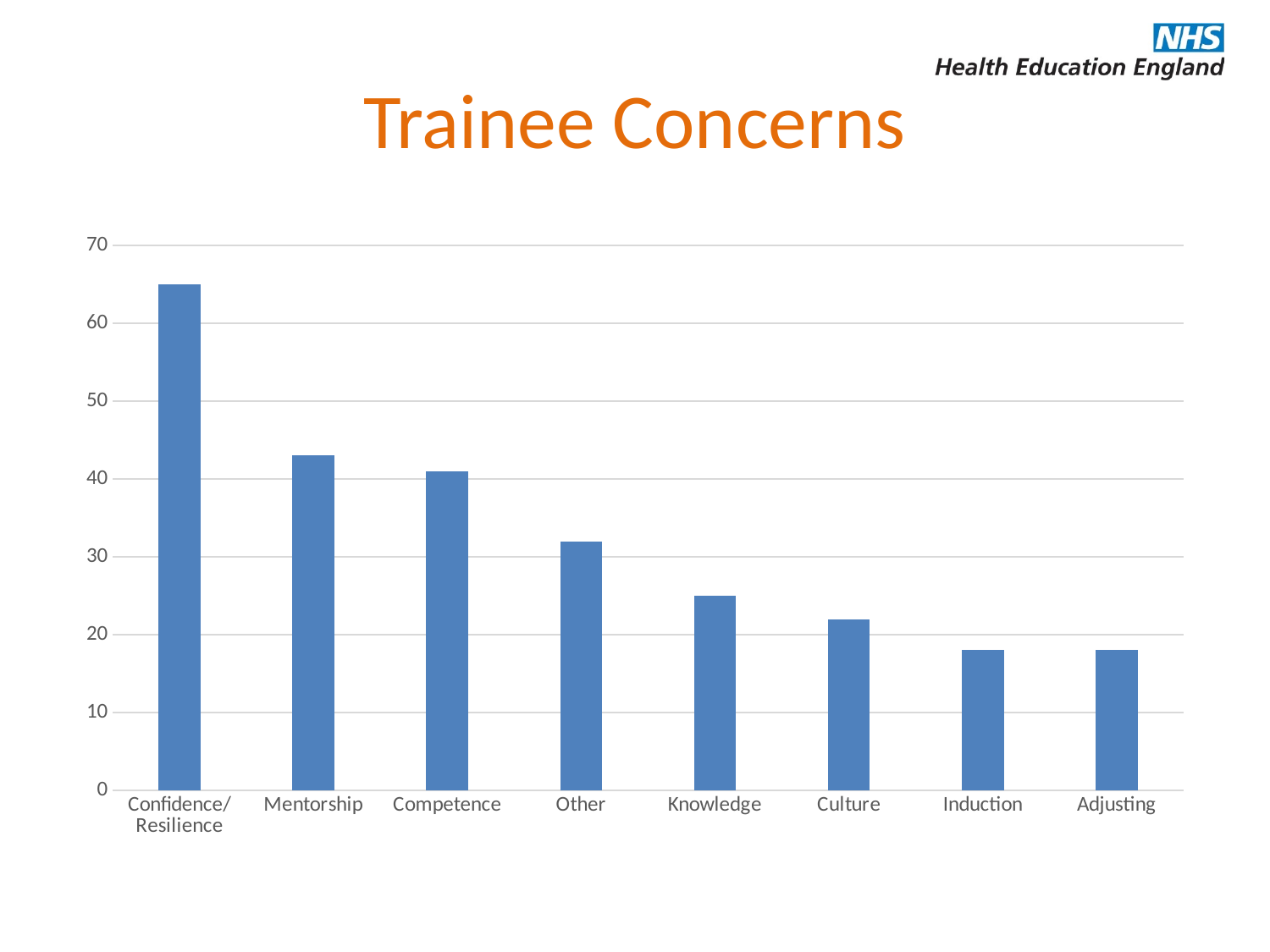
Is the value for Induction greater or less than 20? less What is the title of the slide's chart? Trainee Concerns Is the value for Culture greater or less than 20? greater Is the value for Knowledge greater or less than 30? less How many categories are plotted on the chart? 8 What kind of chart is shown on the slide? bar chart Do the values generally rise or fall moving from left to right along the x axis? fall Which is larger, the value for Other or the value for Knowledge? Other Which category has the highest value? Confidence/Resilience